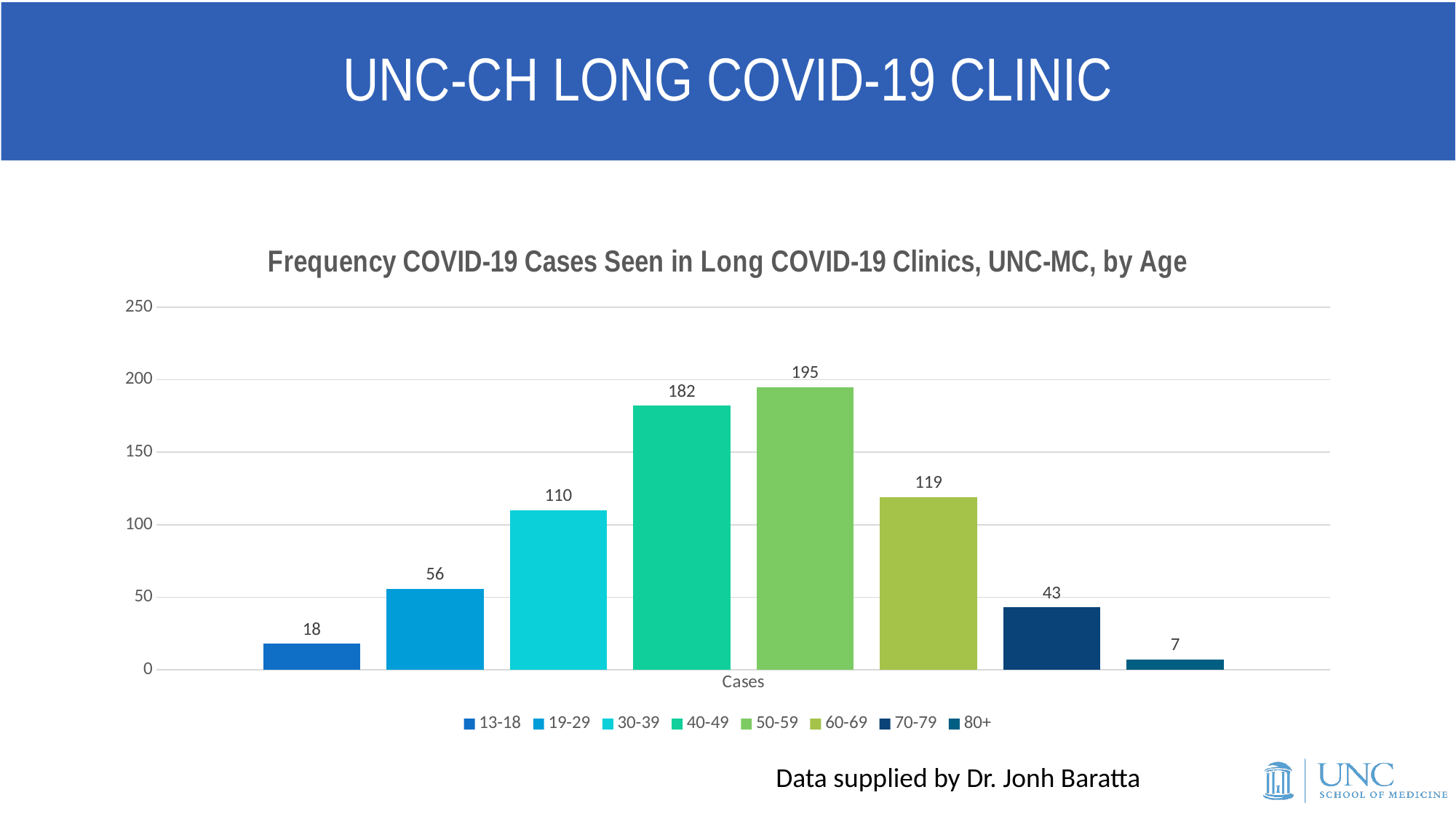
What is the title of the chart? Frequency COVID-19 Cases Seen in Long COVID-19 Clinics, UNC-MC, by Age What kind of chart is shown on the slide? Bar chart Is the value for the 30-39 age group greater or less than 100? greater How many age groups are shown in the chart? 8 What is the difference in cases between the 30-39 and 19-29 age groups? 54 What is the number of cases for the 13-18 age group? 18 Which age group has the lowest number of cases? 80+ What is the difference in cases between the 50-59 and 60-69 age groups? 76 What is the number of cases for the 40-49 age group? 182 Which age group has more cases, 60-69 or 70-79? 60-69 Which age group has the highest number of cases? 50-59 What is the number of cases for the 80+ age group? 7